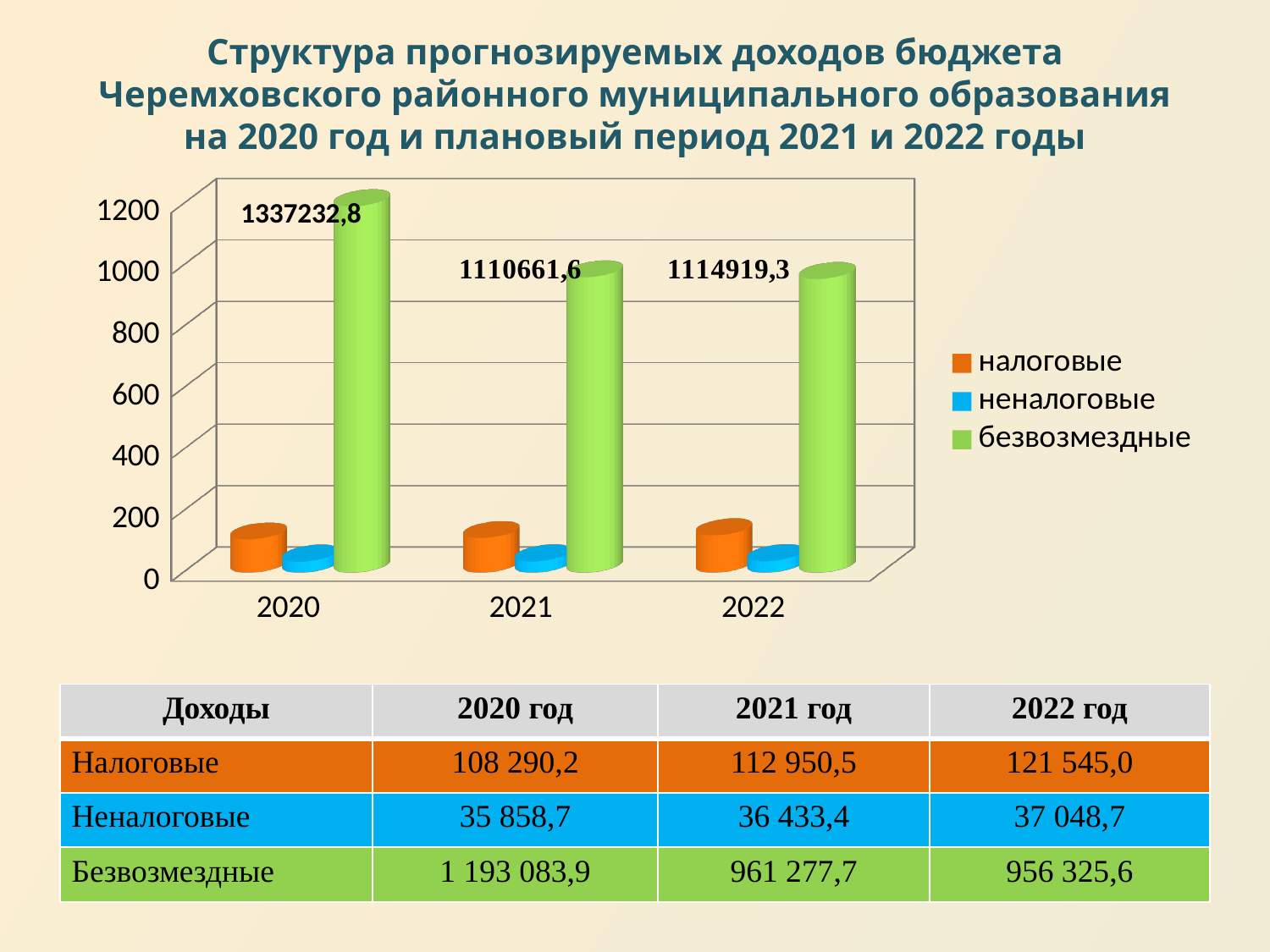
Is the безвозмездные bar for 2020 greater or less than 1000 on the axis? greater Which year has the lowest labelled value on the chart? 2021 Which colour represents безвозмездные in the chart legend? green How many series does the chart legend list? 3 How many years are shown along the x axis of the chart? 3 Which labelled value is larger on the chart, 2021 or 2022? 2022 What value is labelled above the 2022 group of bars? 1114919,3 What value is labelled above the 2020 group of bars? 1337232,8 Which year has the highest labelled value on the chart? 2020 What value is labelled above the 2021 group of bars? 1110661,6 What is the difference between the labelled values for 2020 and 2021 on the chart? 226571,2 What kind of chart is shown on the slide? bar chart